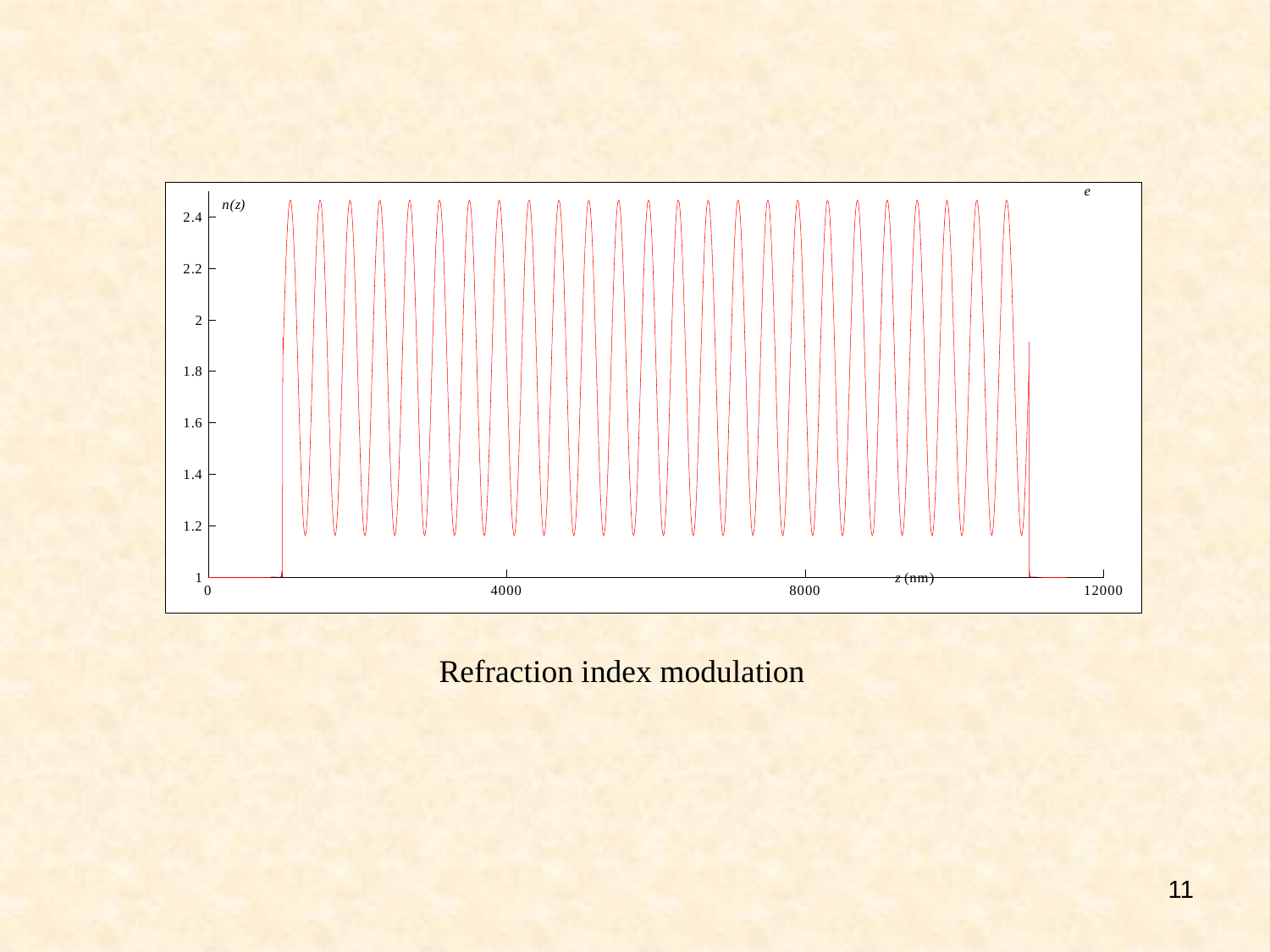
Is the lowest value reached by the oscillating curve greater or less than 1.4? less How many tick labels are printed on the horizontal axis? 4 What is the label on the horizontal axis of the chart? z (nm) What is the label on the vertical axis of the chart? n(z) What is the value of n(z) at z = 12000? 1 Is the highest value reached by the oscillating curve greater or less than 2.2? greater What is the value of n(z) at z = 0? 1 Is the lowest value reached by the oscillating curve greater or less than 1.2? less Between z = 0 and z = 1000, does the value of n(z) rise, fall, or stay flat? stay flat How many tick labels are printed on the vertical axis? 8 What kind of chart is shown on the slide? line chart